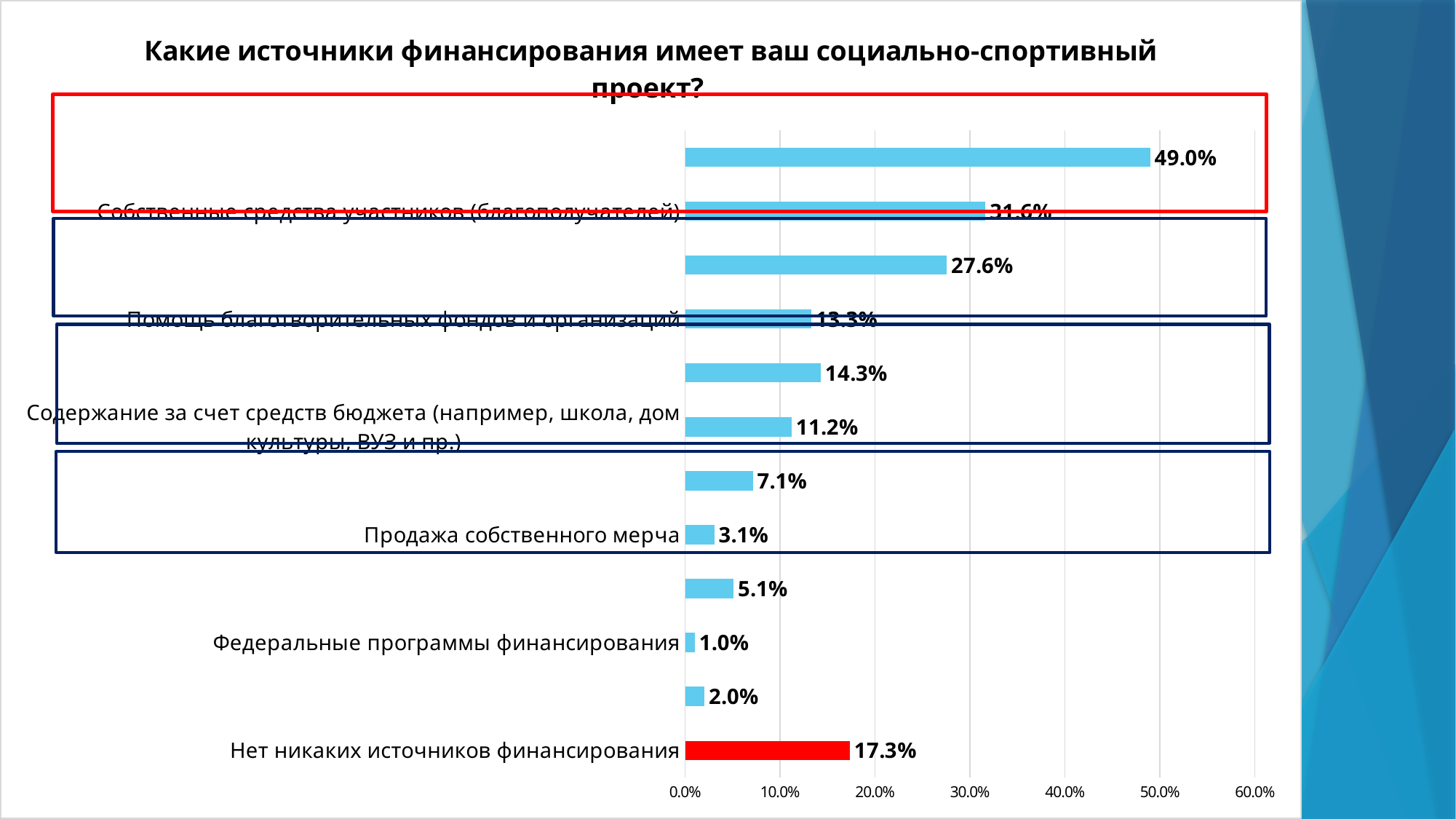
Which labelled category has the lowest value in the chart? Федеральные программы финансирования What is the highest value shown in the chart? 49.0% How many bars are plotted in the chart? 12 What is the value for "Нет никаких источников финансирования"? 17.3% What colour is the bar for "Нет никаких источников финансирования"? red What is the difference between the values for "Нет никаких источников финансирования" and "Продажа собственного мерча"? 14.2% What is the value for "Собственные средства участников (благополучателей)"? 31.6% What is the value for "Продажа собственного мерча"? 3.1% What is the value for "Федеральные программы финансирования"? 1.0% What is the value for "Содержание за счет средств бюджета (например, школа, дом культуры, ВУЗ и пр.)"? 11.2% Which is larger: the value for "Собственные средства участников (благополучателей)" or for "Нет никаких источников финансирования"? Собственные средства участников (благополучателей) What kind of chart is shown on the slide? bar chart